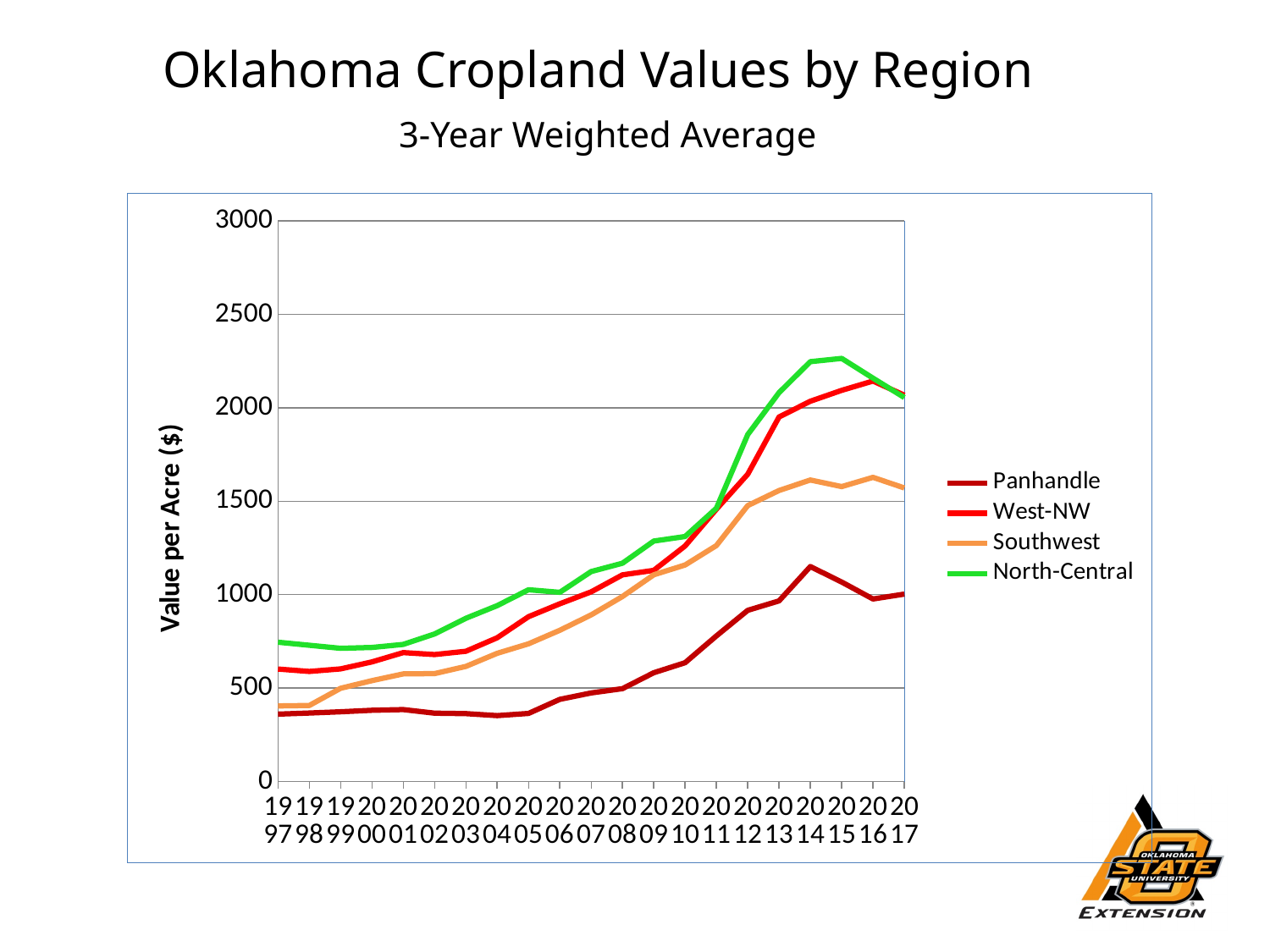
Does the North-Central value rise or fall from 2015 to 2017? fall What kind of chart is shown on the slide? line chart What is the title of the y axis? Value per Acre ($) Is the value for West-NW in 1997 greater or less than 500? greater Is the value for Panhandle in 2014 greater or less than 1000? greater How many years are plotted along the x axis? 21 Which region has the highest cropland value in 2015? North-Central Which is larger in 2012, the value for West-NW or the value for Southwest? West-NW How many series does the legend list? 4 Which region has the lowest cropland value in 2017? Panhandle Does the Panhandle value rise or fall from 1997 to 2014? rise Is the value for Southwest in 2016 greater or less than 1500? greater